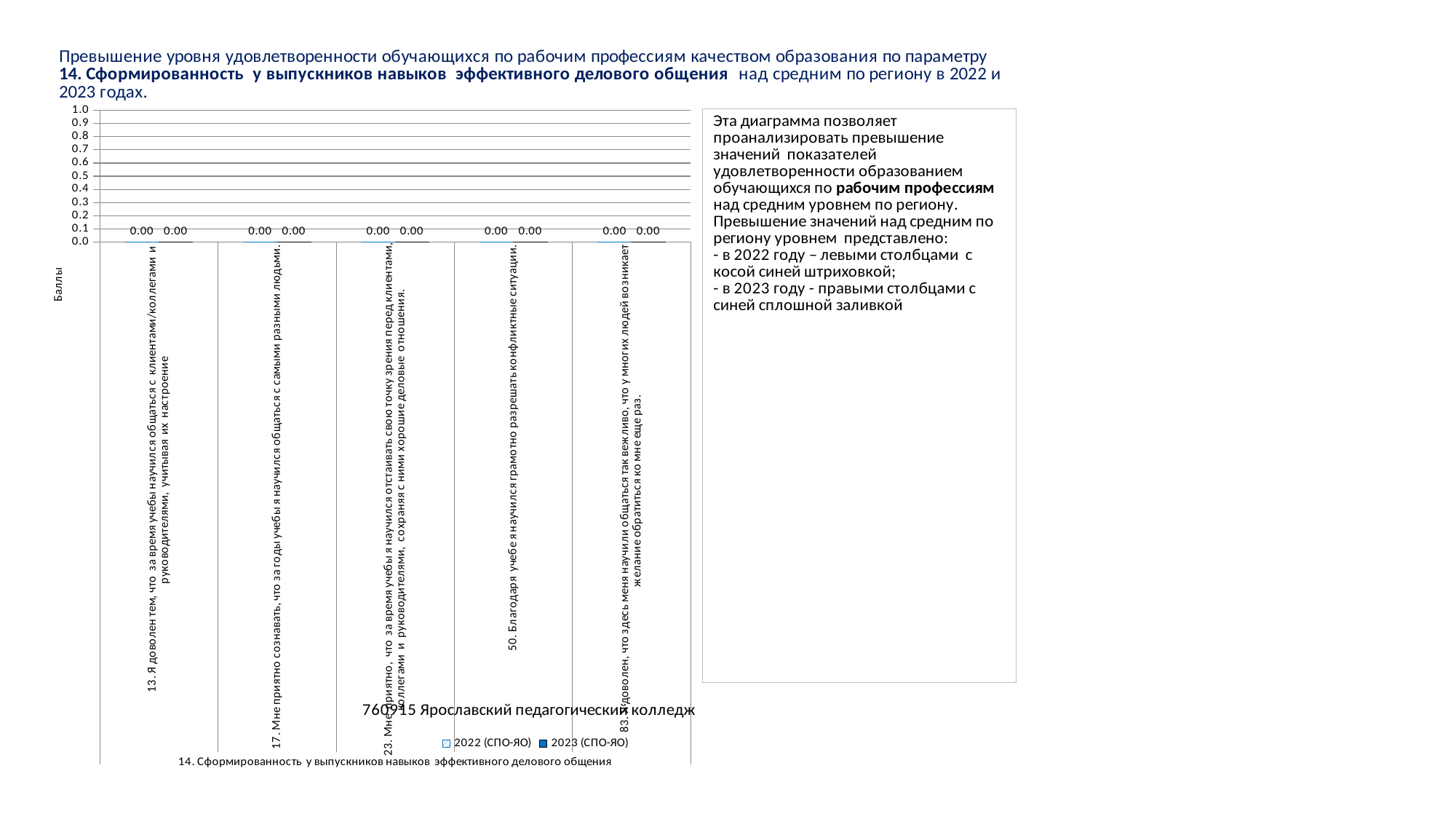
What is the 2022 (СПО-ЯО) value for category 83 ("Я доволен, что здесь меня научили общаться так вежливо...")? 0.00 Do the 2023 (СПО-ЯО) values rise, fall, or stay the same across the categories on the x axis? stay the same What is the difference between the 2022 (СПО-ЯО) and 2023 (СПО-ЯО) values for category 17? 0.00 How many series does the chart legend list? 2 What is the 2022 (СПО-ЯО) value for category 13 ("Я доволен тем, что за время учебы научился общаться с клиентами/коллегами и руководителями...")? 0.00 What kind of chart is shown on the slide? bar chart What label is shown on the vertical axis of the chart? Баллы What is the highest value shown on the vertical axis of the chart? 1.0 How many categories are plotted on the x axis of the chart? 5 Is the 2023 (СПО-ЯО) value for category 23 greater or less than 0.5? less What is the 2023 (СПО-ЯО) value for category 50 ("Благодаря учебе я научился грамотно разрешать конфликтные ситуации")? 0.00